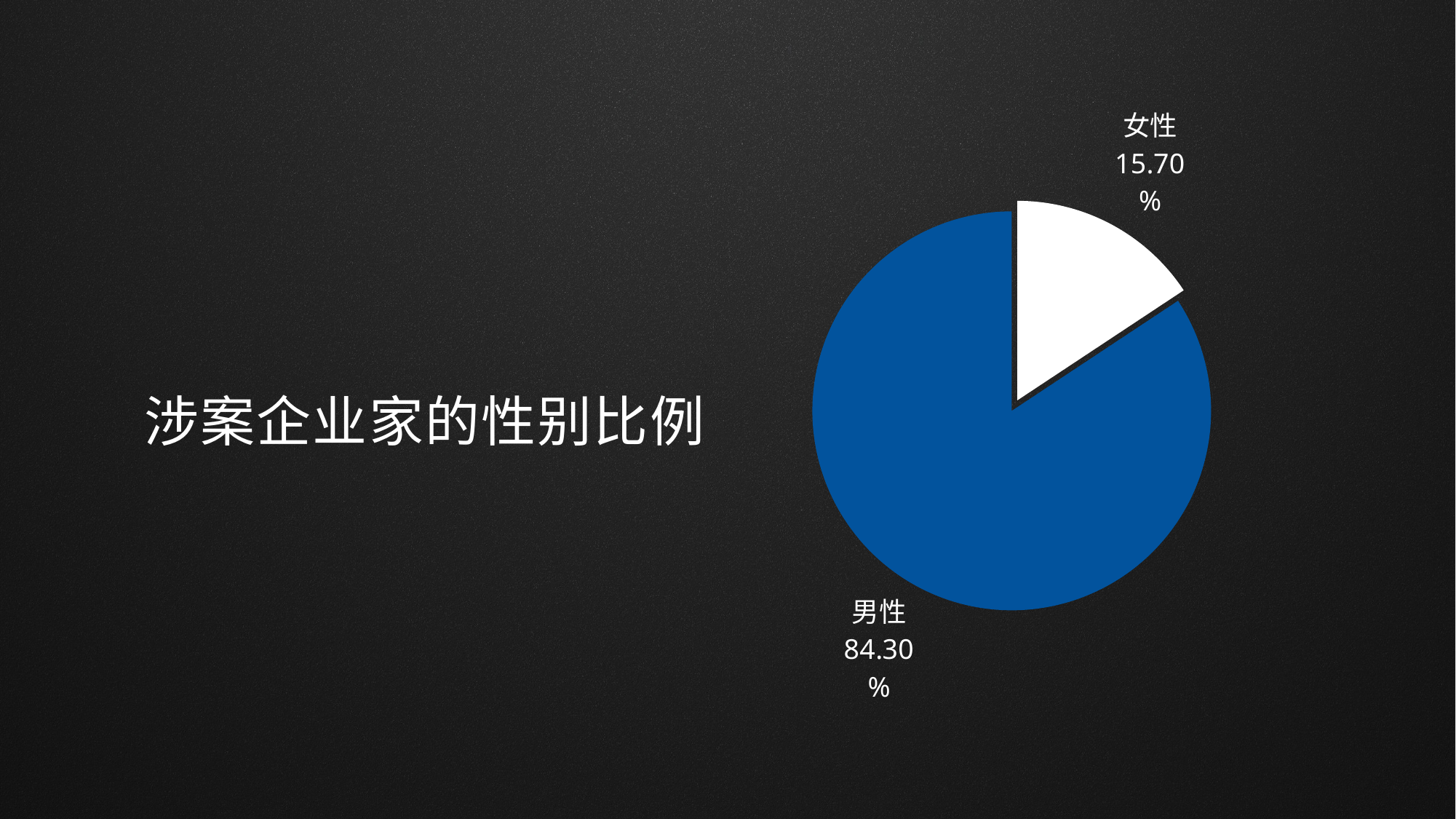
How many slices does the pie chart have? 2 What kind of chart is shown on the slide? pie chart What colour is the 男性 slice of the pie chart? blue Which is larger, the share for 男性 or the share for 女性? 男性 What is the value for 男性 in the pie chart? 84.30% What share of the pie does the 女性 slice represent? 15.70% What is the value for 女性 in the pie chart? 15.70% What is the title shown on the slide for the chart? 涉案企业家的性别比例 Which category has the smallest share of the pie? 女性 What is the difference between the shares for 男性 and 女性? 68.60% Which category has the largest share of the pie? 男性